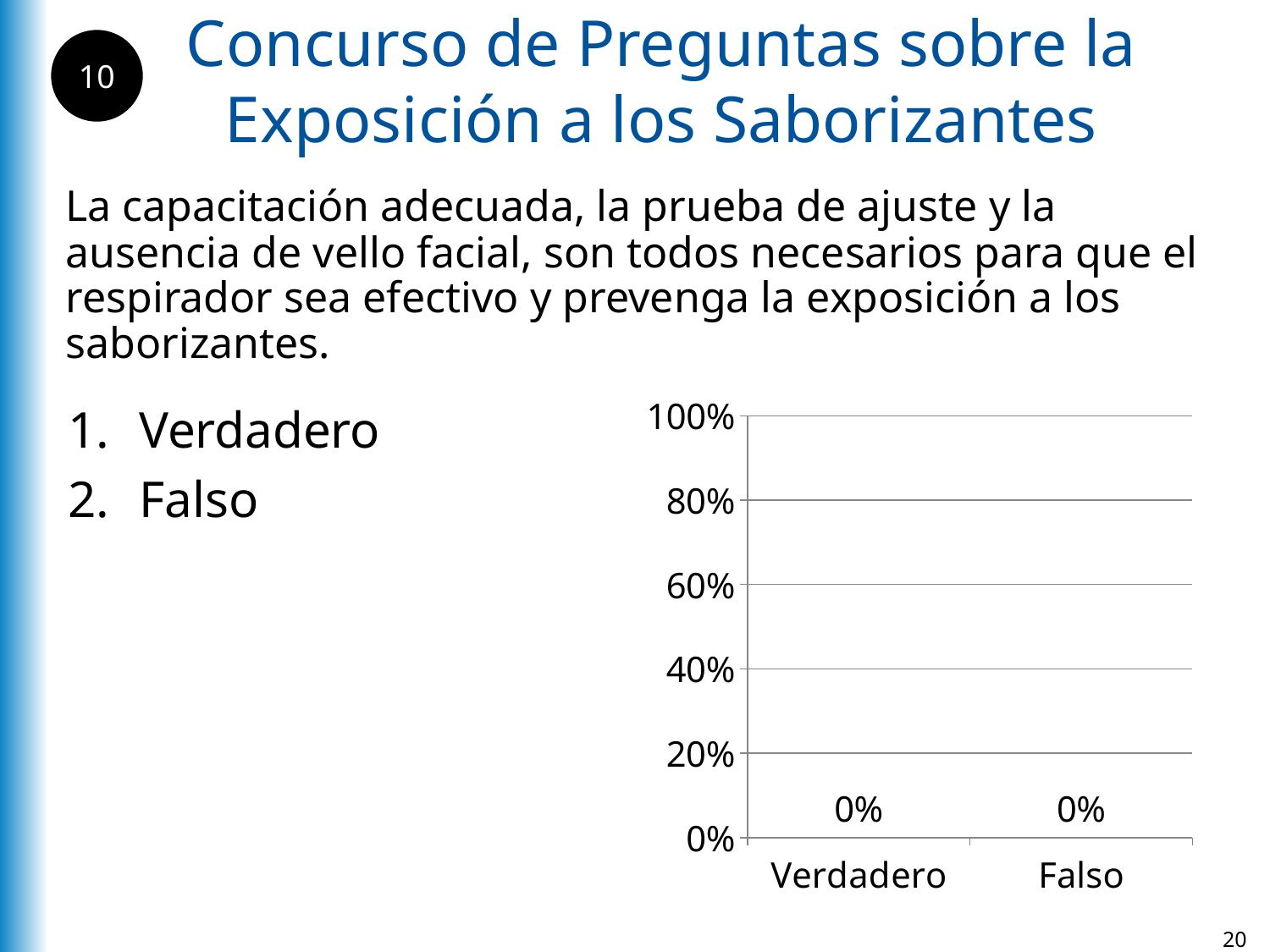
What are the two category labels on the x axis of the chart? Verdadero and Falso How many categories are shown on the x axis of the chart? 2 Is the value for Falso greater or less than 20%? less What value is shown for Falso in the chart? 0% What is the difference between the values for Verdadero and Falso? 0% Is the value for Verdadero greater or less than 20%? less What value is shown for Verdadero in the chart? 0% What kind of chart is shown on the slide? bar chart What is the highest value shown on the chart's y axis? 100%